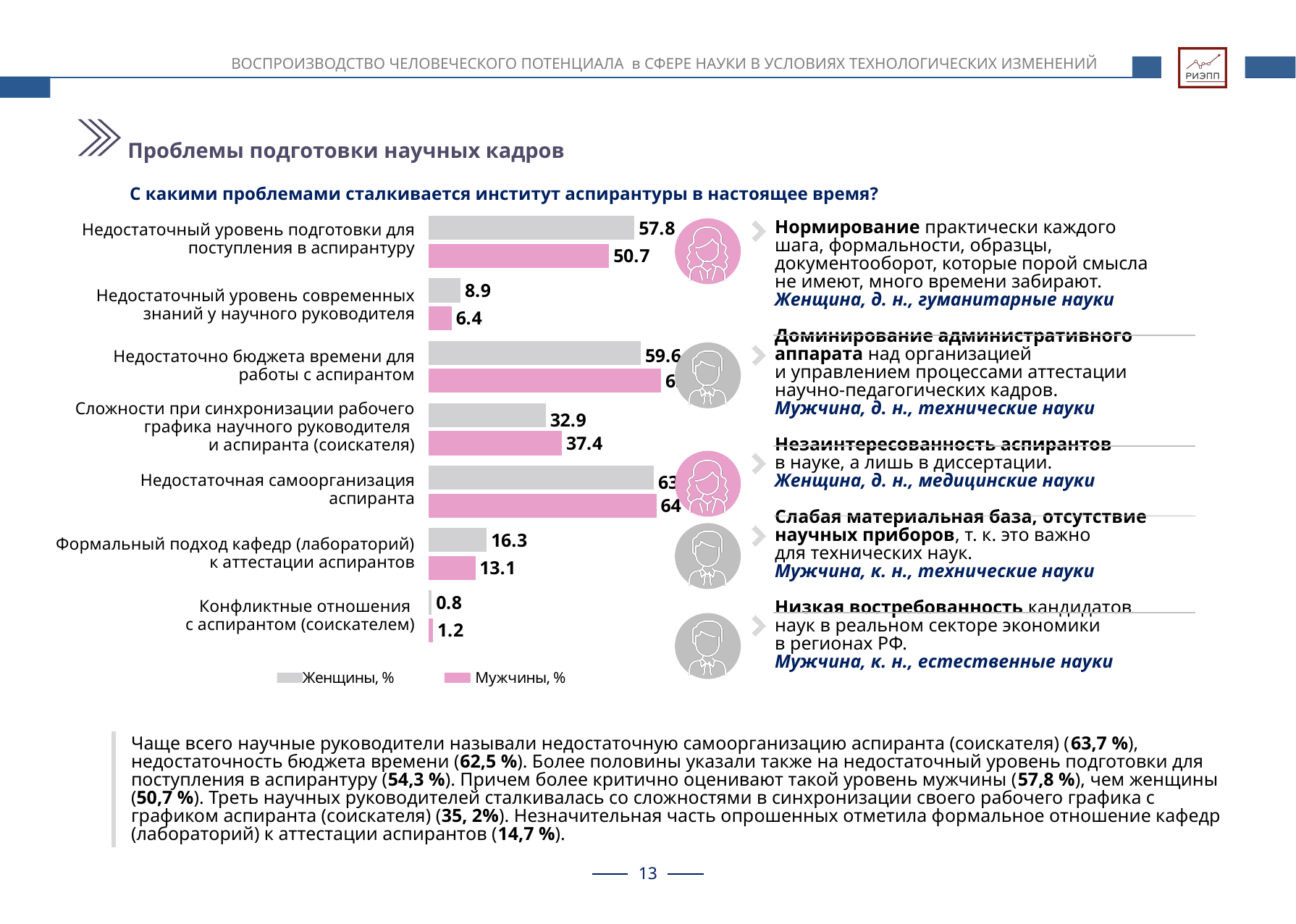
Какие ряды данных перечислены в легенде диаграммы? Женщины, %; Мужчины, % По какой категории значение для женщин самое низкое? Конфликтные отношения с аспирантом (соискателем) Каково значение для женщин по категории «Сложности при синхронизации рабочего графика научного руководителя и аспиранта (соискателя)»? 32.9 На сколько значение для мужчин превышает значение для женщин по категории «Сложности при синхронизации рабочего графика научного руководителя и аспиранта (соискателя)»? 4.5 Каково значение для женщин по категории «Недостаточный уровень современных знаний у научного руководителя»? 8.9 Какова разница между значениями для женщин и мужчин по категории «Формальный подход кафедр (лабораторий) к аттестации аспирантов»? 3.2 Сколько рядов данных указано в легенде диаграммы? 2 Сколько категорий (проблем) представлено на диаграмме? 7 Какой тип диаграммы показан на слайде? Столбчатая (линейчатая) диаграмма По категории «Формальный подход кафедр (лабораторий) к аттестации аспирантов» значение выше у женщин или у мужчин? У женщин Каково значение для мужчин по категории «Формальный подход кафедр (лабораторий) к аттестации аспирантов»? 13.1 Каково значение для мужчин по категории «Конфликтные отношения с аспирантом (соискателем)»? 1.2